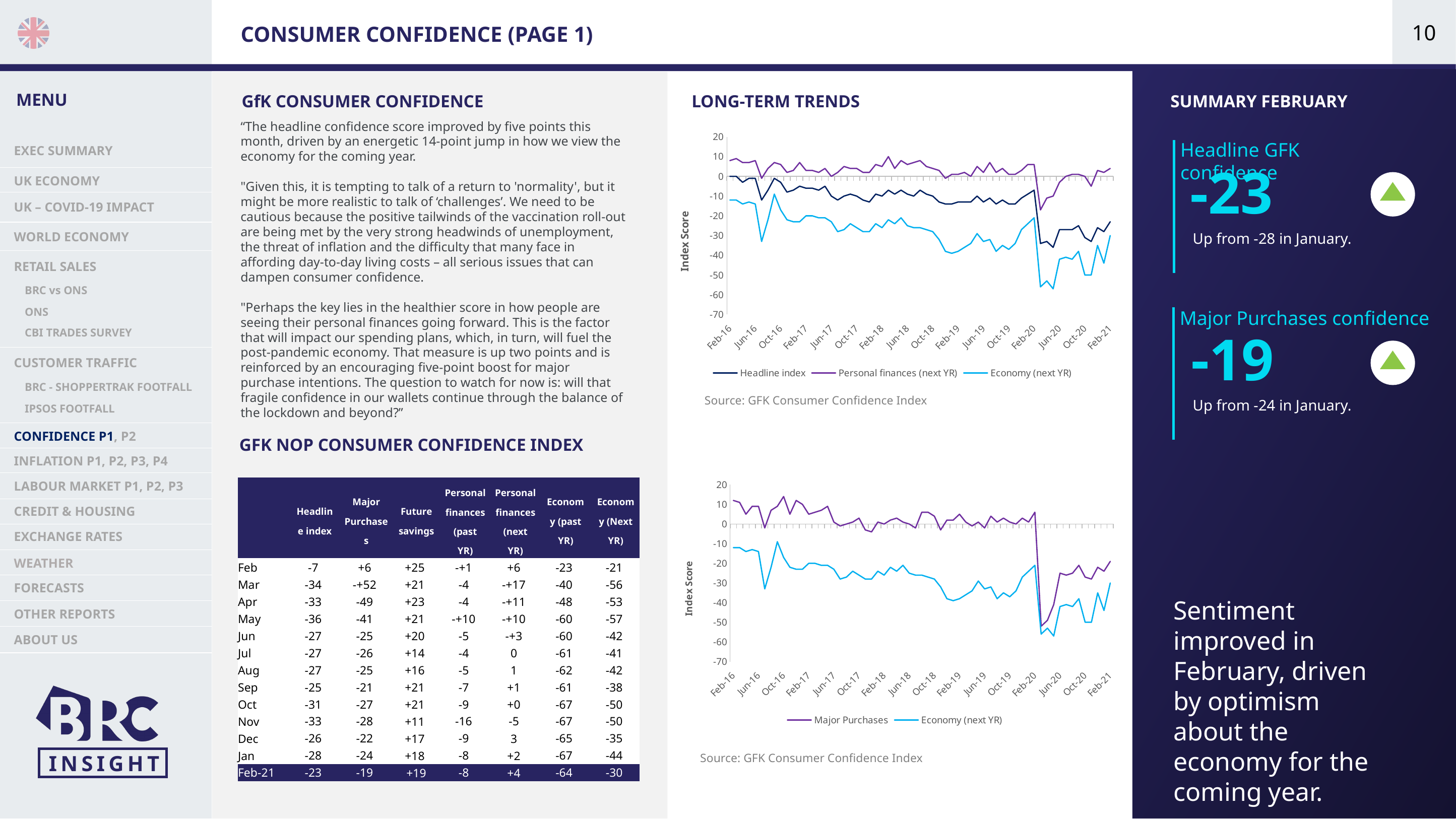
How many series does the legend of the bottom LONG-TERM TRENDS chart list? 2 In the top LONG-TERM TRENDS chart, which is higher at Feb-16: Headline index or Economy (next YR)? Headline index What is the y-axis label on the LONG-TERM TRENDS charts? Index Score In the top LONG-TERM TRENDS chart, is the value for Personal finances (next YR) at Feb-16 greater or less than 0? greater What are the legend entries of the bottom LONG-TERM TRENDS chart? Major Purchases, Economy (next YR) In the top LONG-TERM TRENDS chart, does the Economy (next YR) line rise or fall between Feb-20 and Jun-20? Fall In the top LONG-TERM TRENDS chart, is the value for Headline index at Feb-16 greater or less than -10? greater In the top LONG-TERM TRENDS chart, is the value for Economy (next YR) at Feb-16 greater or less than -20? greater How many series does the legend of the top LONG-TERM TRENDS chart list? 3 What kind of chart is the top chart under LONG-TERM TRENDS? Line chart